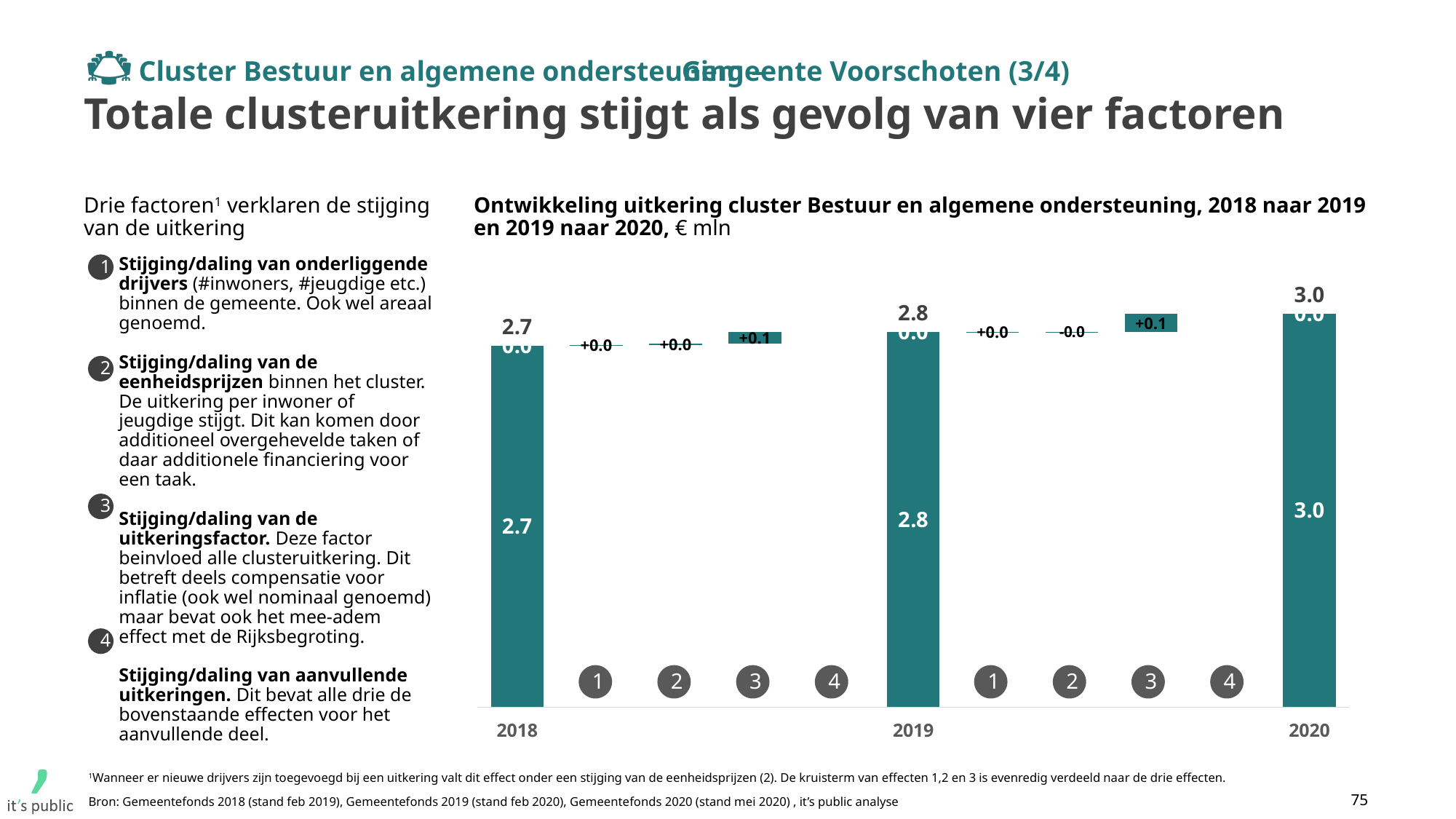
Do the total values rise or fall from 2018 to 2020? rise What is the total uitkering value shown for 2019? 2.8 Which year has the lowest total uitkering value? 2018 What is the value of factor 3 between 2018 and 2019? +0.1 What is the difference between the 2019 total and the 2018 total? 0.1 What is the value of factor 3 between 2019 and 2020? +0.1 What is the total uitkering value shown for 2020? 3.0 What unit is stated in the chart title? € mln Is the total for 2019 larger or smaller than the total for 2020? smaller What is the total uitkering value shown for 2018? 2.7 Which year has the highest total uitkering value? 2020 What is the difference between the 2020 total and the 2018 total? 0.3